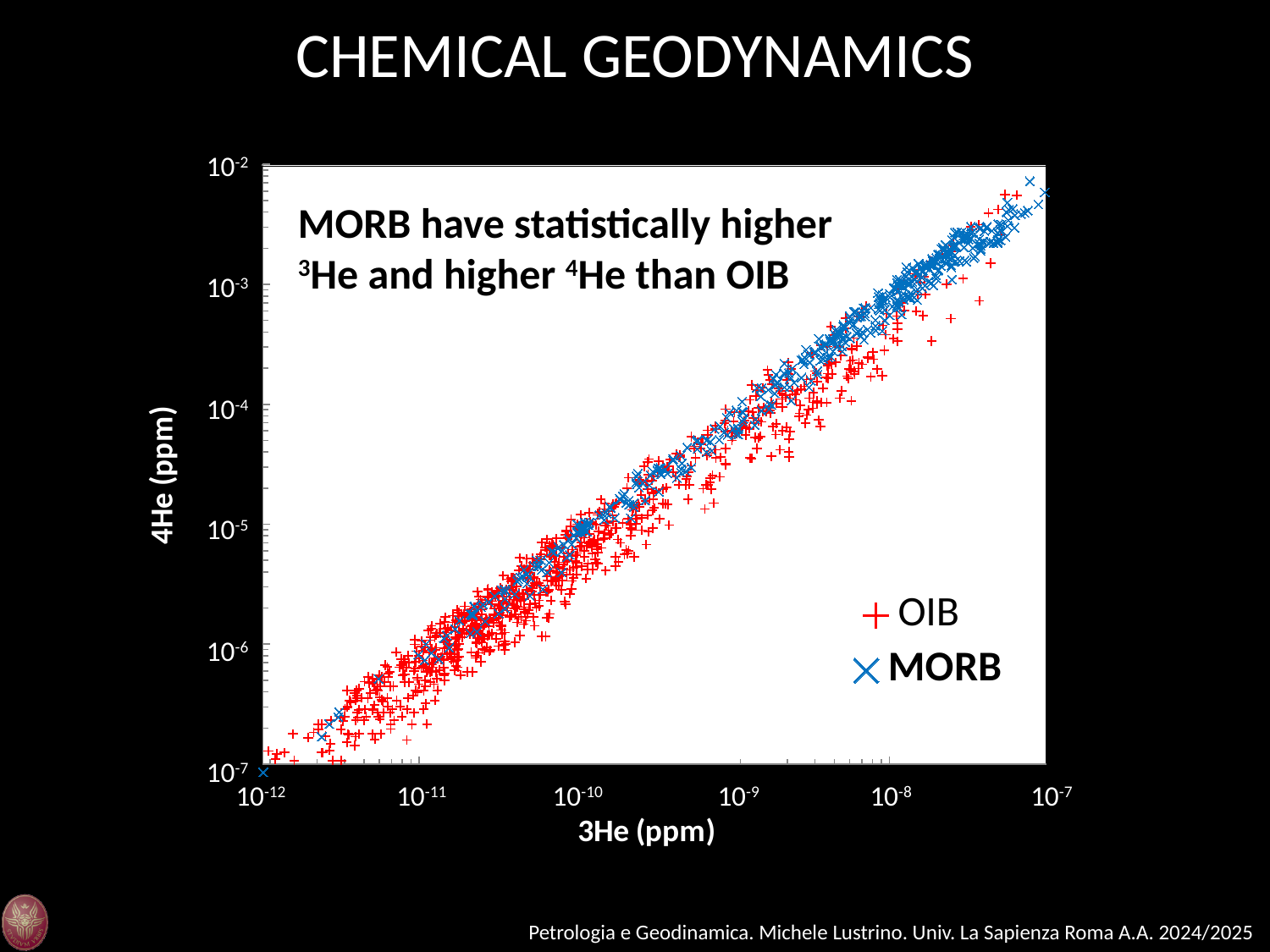
Which series, OIB or MORB, has statistically higher 3He and 4He according to the slide? MORB What kind of chart is shown on the slide? Scatter plot What is the lowest tick value shown on the y axis? 10^-7 As 3He increases along the x axis, do the 4He values rise or fall? Rise What is the lowest tick value shown on the x axis? 10^-12 What are the two series named in the legend? OIB and MORB What is the highest tick value shown on the y axis? 10^-2 What is the label of the y axis? 4He (ppm) What is the label of the x axis? 3He (ppm) What is the highest tick value shown on the x axis? 10^-7 How many series does the legend list? 2